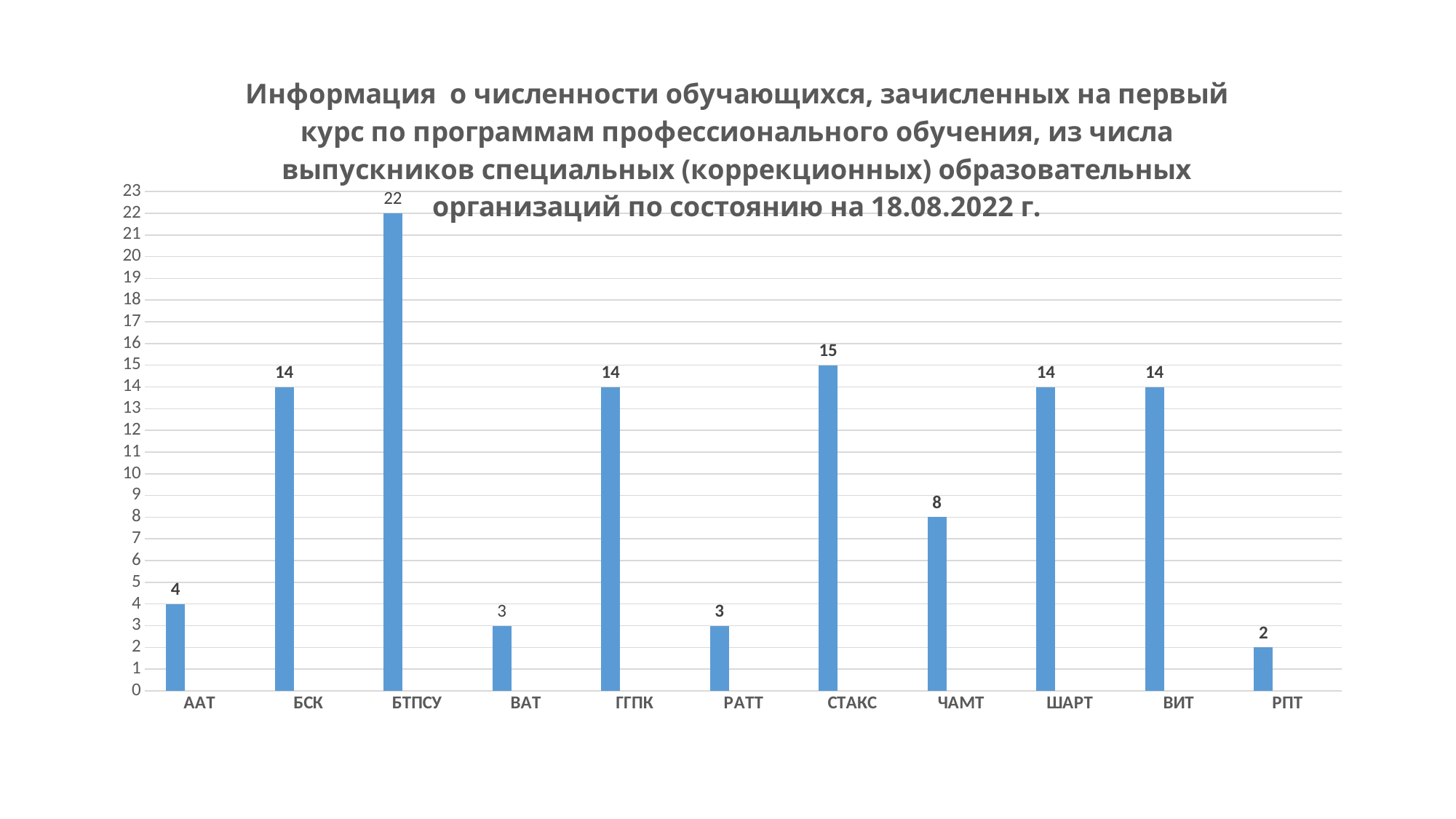
Which category has the highest value? БТПСУ What is the value for БТПСУ? 22 How many categories are shown on the x axis? 11 Is the value for БТПСУ greater or less than 20? greater Which is larger, the value for ААТ or the value for ЧАМТ? ЧАМТ How many categories have a value of 14? 4 What is the difference between the values for БТПСУ and СТАКС? 7 What is the value for РПТ? 2 What kind of chart is shown on the slide? bar chart What is the value for ЧАМТ? 8 What is the value for СТАКС? 15 Which category has the lowest value? РПТ